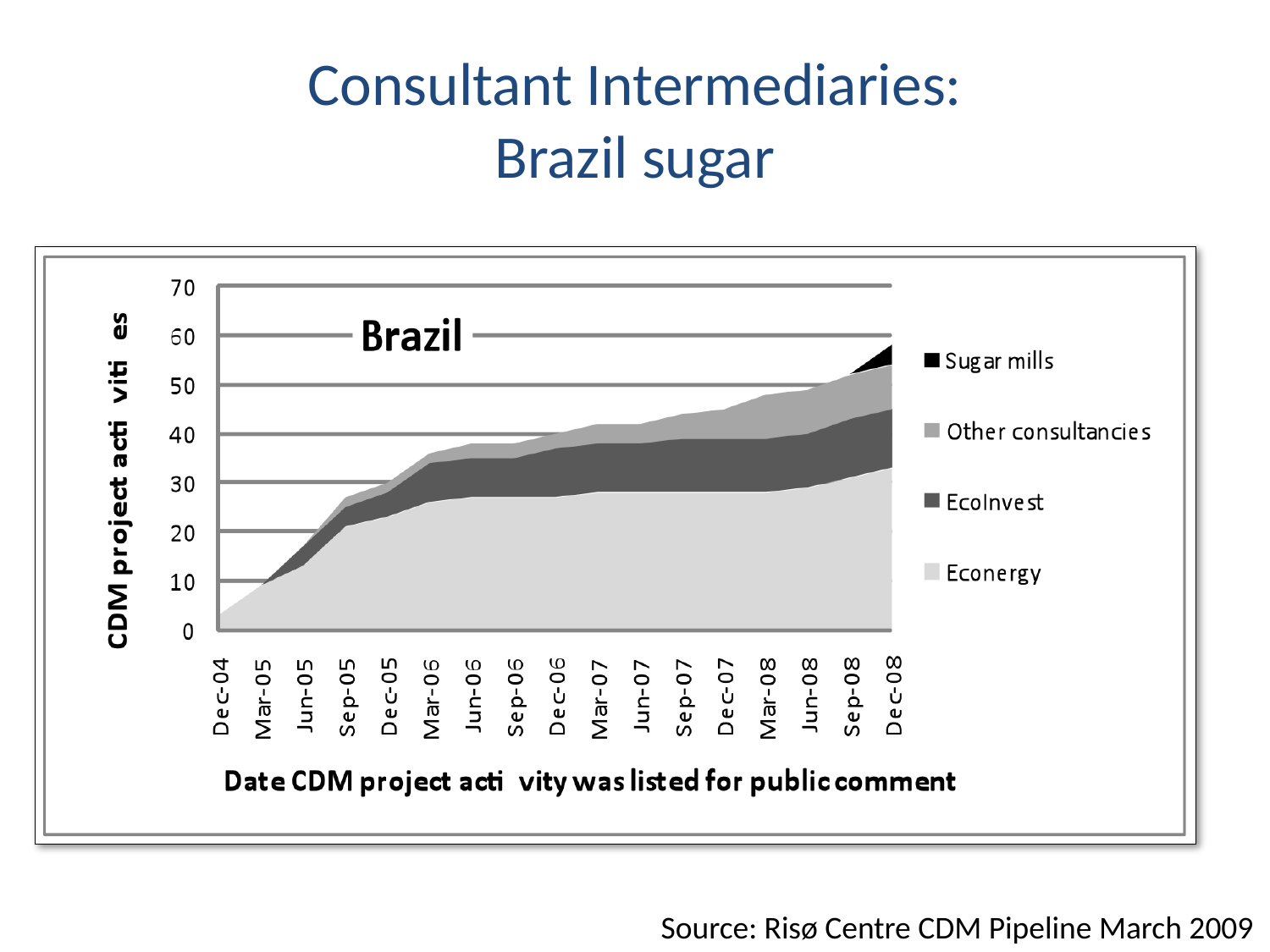
Does the total number of CDM project activities rise or fall from Dec-04 to Dec-08? Rise Which series forms the bottom layer of the stacked area? Econergy What title is printed inside the chart area? Brazil Is the Econergy value at Dec-08 greater or less than 20? greater Is the total stacked value at Dec-07 greater or less than 40? greater Is the total stacked value at Jun-05 greater or less than 20? less What kind of chart is shown on the slide? Stacked area chart How many dates are labelled along the x axis? 17 How many series does the legend list? 4